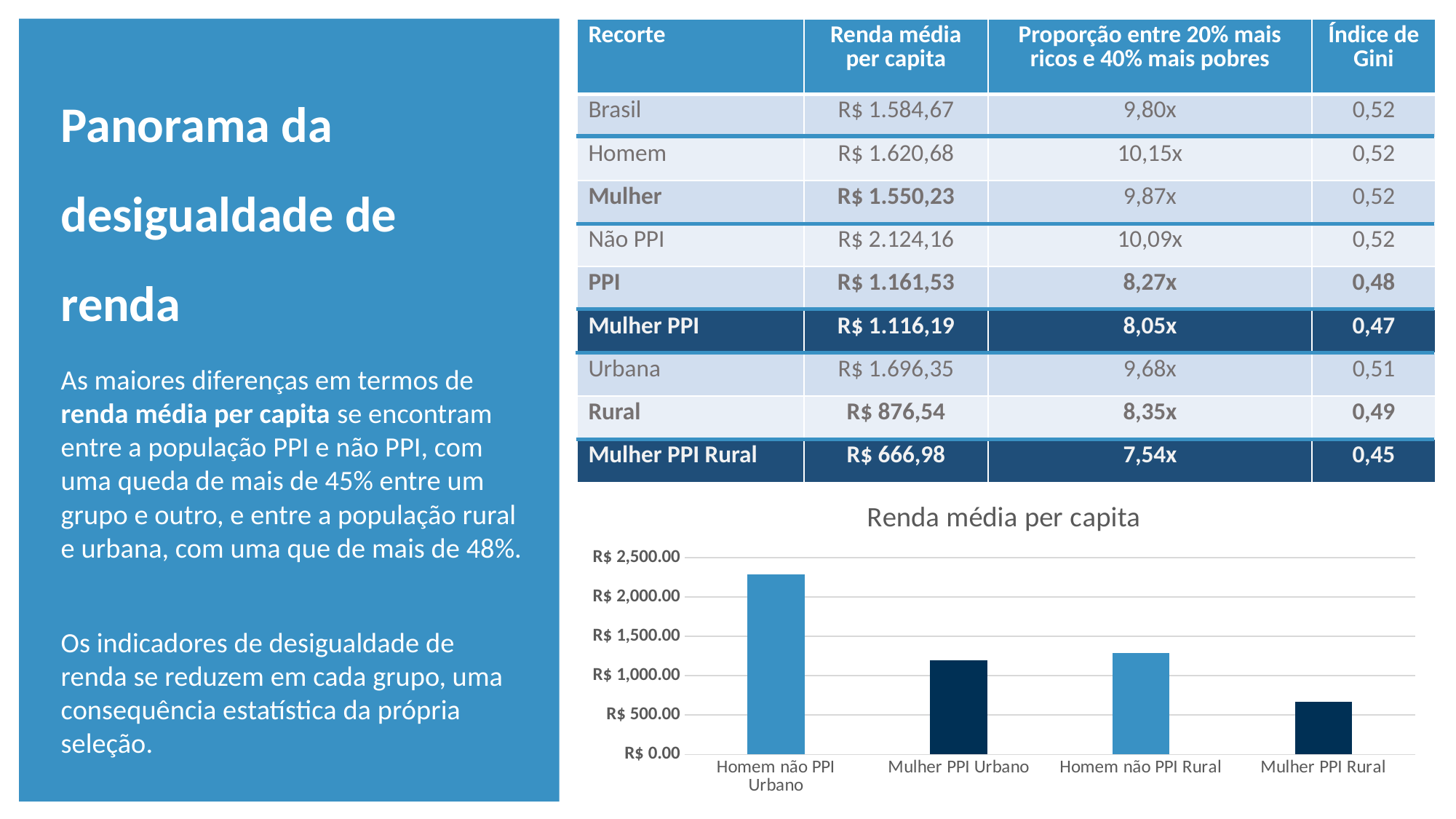
How many categories are plotted in the "Renda média per capita" chart? 4 In the "Renda média per capita" chart, is the value for Mulher PPI Urbano greater or less than R$ 1,000.00? greater In the "Renda média per capita" chart, is the value for Mulher PPI Rural greater or less than R$ 1,000.00? less Which category has the lowest value in the "Renda média per capita" chart? Mulher PPI Rural In the "Renda média per capita" chart, which is larger: Homem não PPI Urbano or Mulher PPI Rural? Homem não PPI Urbano Which category has the highest value in the "Renda média per capita" chart? Homem não PPI Urbano What kind of chart is shown under the title "Renda média per capita"? bar chart In the "Renda média per capita" chart, is the value for Homem não PPI Urbano greater or less than R$ 2,000.00? greater What is the title of the bar chart on the slide? Renda média per capita In the "Renda média per capita" chart, which is larger: Homem não PPI Rural or Mulher PPI Rural? Homem não PPI Rural